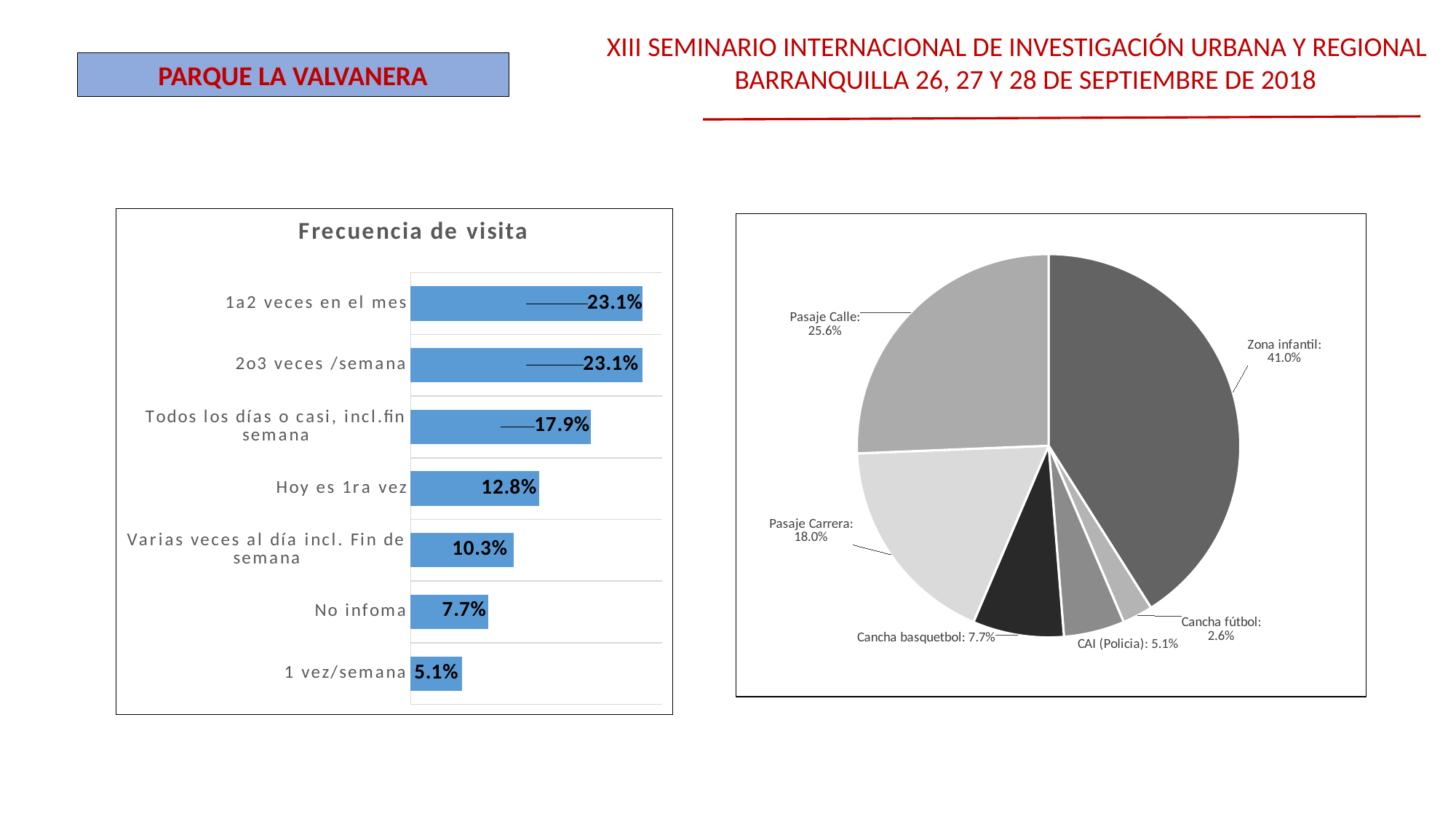
What kind of chart is the 'Frecuencia de visita' chart on the left? Bar chart In the 'Frecuencia de visita' chart, which category has the lowest value? 1 vez/semana In the 'Frecuencia de visita' chart, what is the value for 'Hoy es 1ra vez'? 12.8% In the 'Frecuencia de visita' chart, what is the difference between 'Todos los días o casi, incl.fin semana' and 'Varias veces al día incl. Fin de semana'? 7.6% In the pie chart on the right, which slice is the smallest? Cancha fútbol How many categories does the 'Frecuencia de visita' chart show? 7 In the 'Frecuencia de visita' chart, what is the value for 'No infoma'? 7.7% How many slices does the pie chart on the right have? 6 In the pie chart on the right, what is the share for 'Zona infantil'? 41.0% In the pie chart on the right, what is the value for 'Pasaje Carrera'? 18.0% In the pie chart on the right, what is the difference between 'Pasaje Calle' and 'Cancha basquetbol'? 17.9% In the 'Frecuencia de visita' chart, which is larger: 'Hoy es 1ra vez' or 'No infoma'? Hoy es 1ra vez